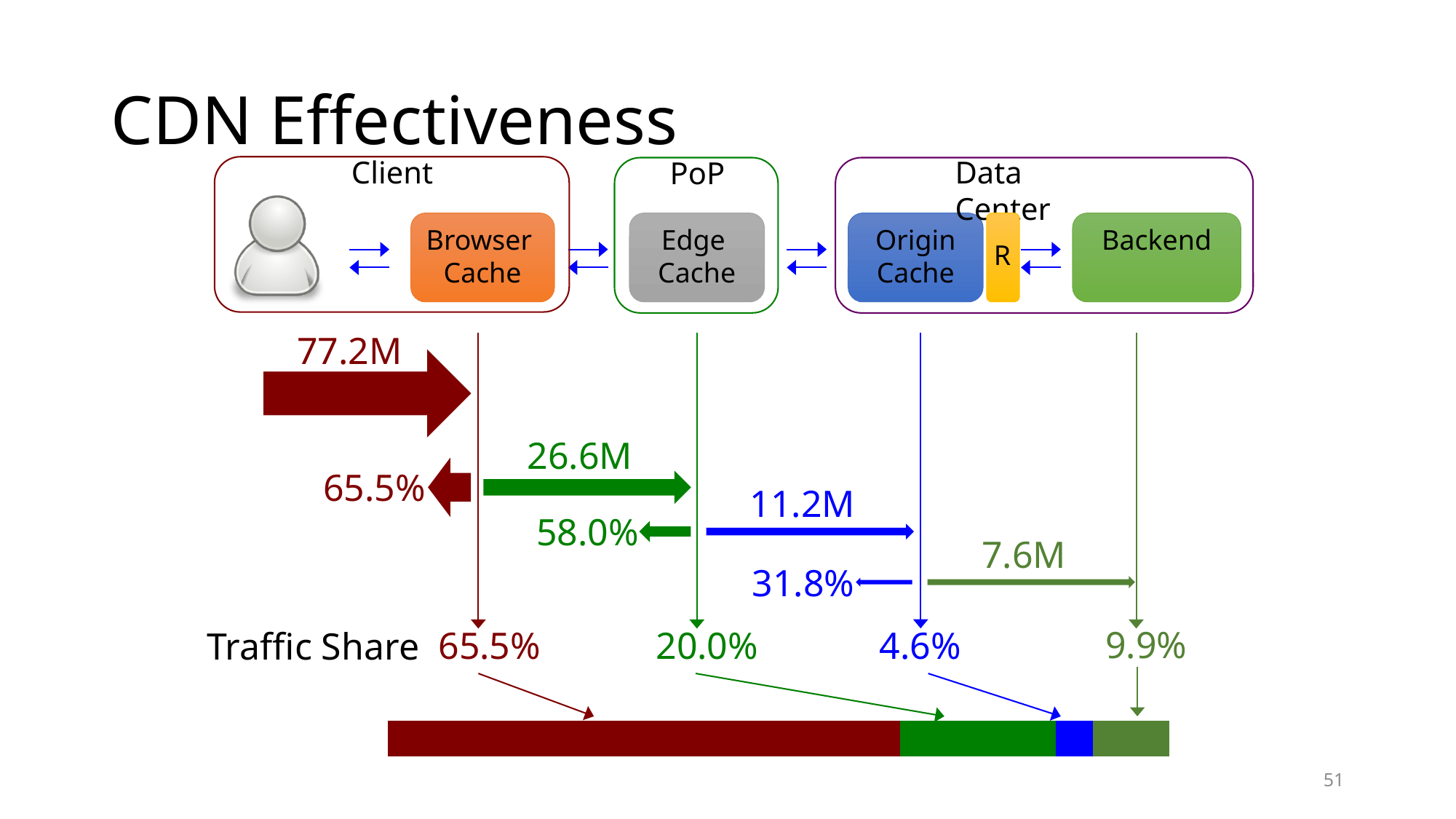
How many requests flow from the Edge Cache to the Origin Cache? 11.2M How many segments does the Traffic Share stacked bar have? 4 Which component has the highest traffic share? Browser Cache (65.5%) What hit rate is shown for the Edge Cache? 58.0% What kind of chart is the Traffic Share graphic at the bottom of the slide? Stacked bar chart In the Traffic Share bar, what is the traffic share for the Edge Cache? 20.0% Which has a larger traffic share, the Backend or the Origin Cache? Backend How many requests flow from the Client into the Browser Cache? 77.2M What is the difference between the requests reaching the Edge Cache (26.6M) and those reaching the Origin Cache (11.2M)? 15.4M Which component has the lowest traffic share? Origin Cache (4.6%) In the Traffic Share bar, what is the traffic share for the Backend? 9.9% What is the difference between the Browser Cache traffic share and the Edge Cache traffic share? 45.5%